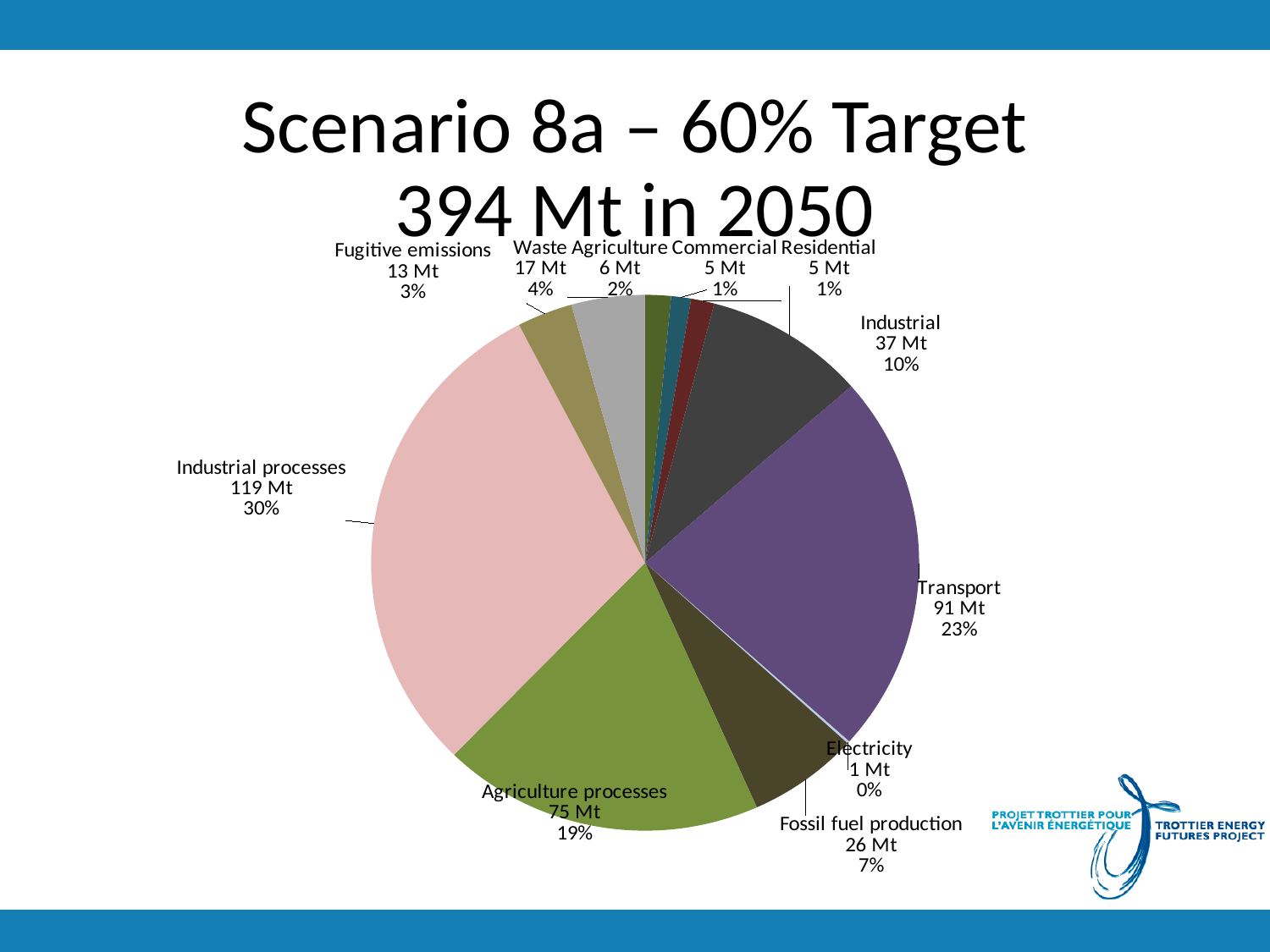
What is the value for Fossil fuel production? 26 Mt What is the difference in Mt between Industrial processes and Agriculture processes? 44 Mt What is the value for Fugitive emissions? 13 Mt What total amount in Mt does the chart title state for 2050? 394 Mt What share of the pie does Industrial processes represent? 30% What type of chart is shown on the slide? Pie chart Which category has the largest slice of the pie? Industrial processes What is the value for Transport? 91 Mt Which category has the smallest slice of the pie? Electricity How many categories are shown in the pie chart? 11 What percentage share is shown for Waste? 4% Which is larger, Industrial or Fossil fuel production? Industrial